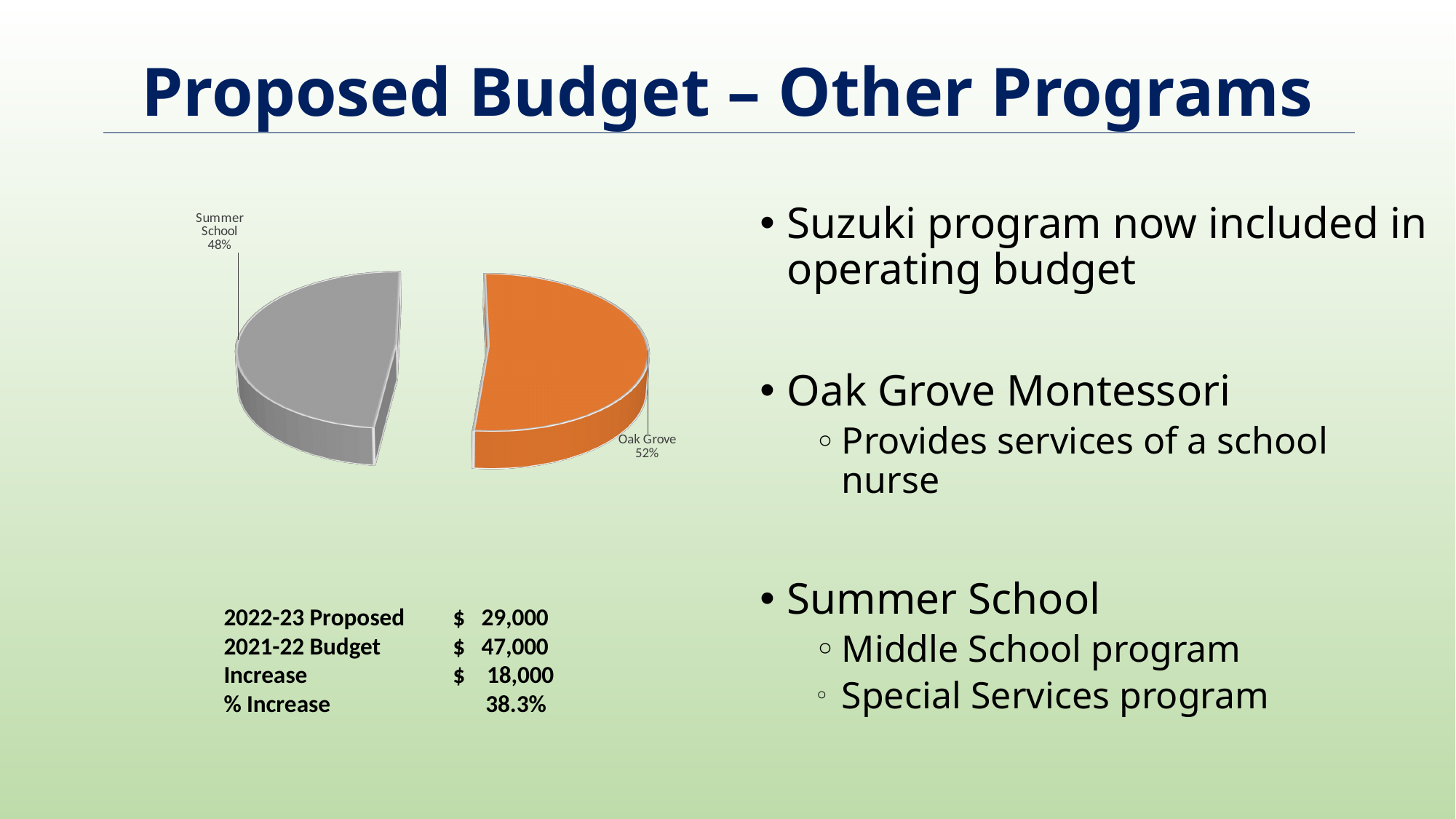
Which slice is larger, Summer School or Oak Grove? Oak Grove How many slices does the pie chart have? 2 What kind of chart is shown on the slide? Pie chart What share of the pie chart does Summer School represent? 48% What colour is the Summer School slice of the pie chart? Gray What is the difference in percentage points between the Oak Grove and Summer School slices? 4 Is the share for Summer School greater or less than 50%? less Which slice of the pie chart is the smallest? Summer School What colour is the Oak Grove slice of the pie chart? Orange Which slice of the pie chart is the largest? Oak Grove What share of the pie chart does Oak Grove represent? 52%